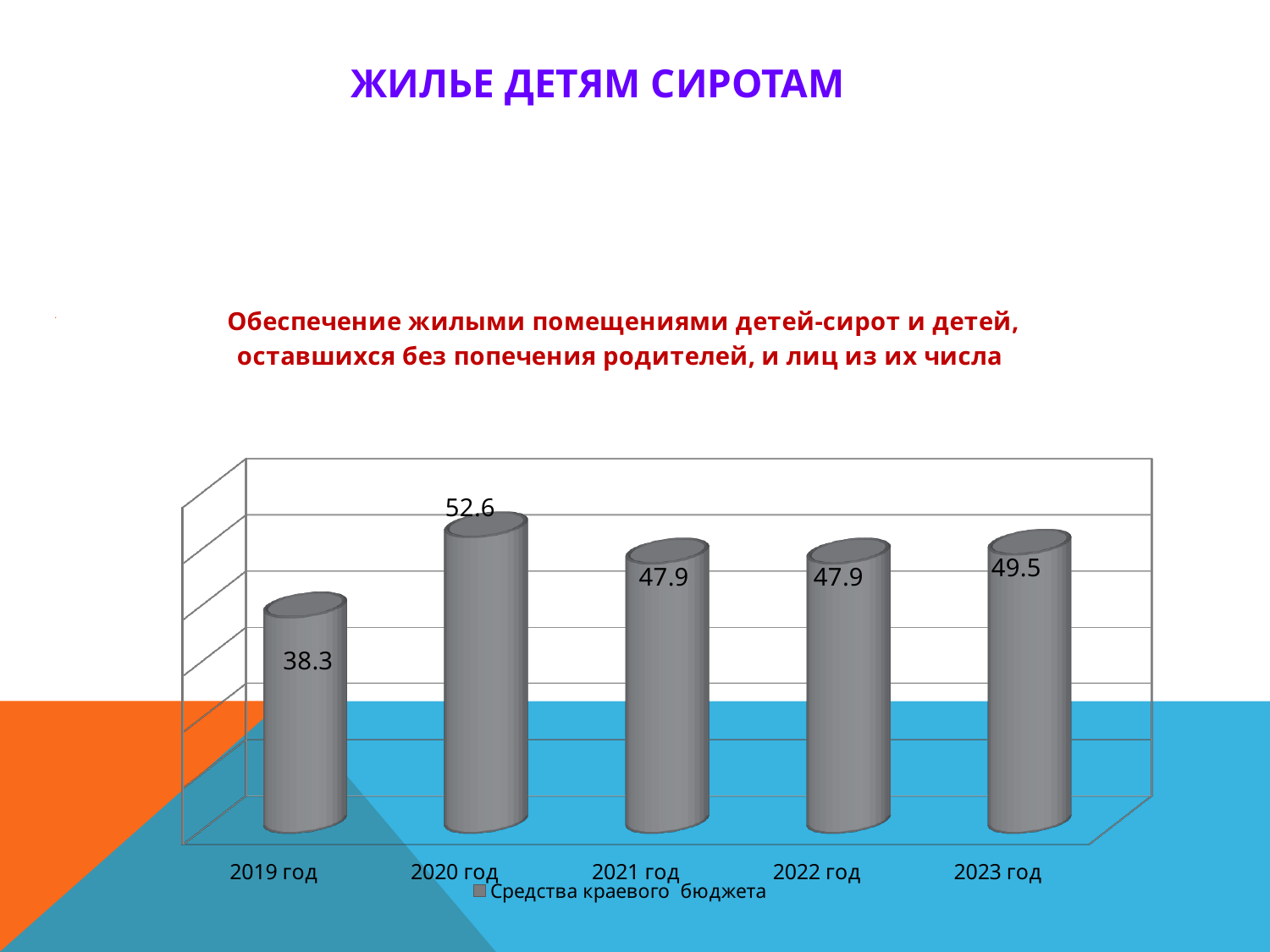
What is the difference between the values for 2023 год and 2022 год? 1.6 Which year has the highest value? 2020 год How many years are shown on the x axis? 5 What kind of chart is shown? bar chart Which is larger, the value for 2021 год or the value for 2023 год? 2023 год What is the value for 2020 год? 52.6 What is the value for 2023 год? 49.5 What is the value for 2019 год? 38.3 Which year has the lowest value? 2019 год How many series does the legend list? 1 What is the legend entry for the series? Средства краевого бюджета What is the difference between the values for 2020 год and 2019 год? 14.3